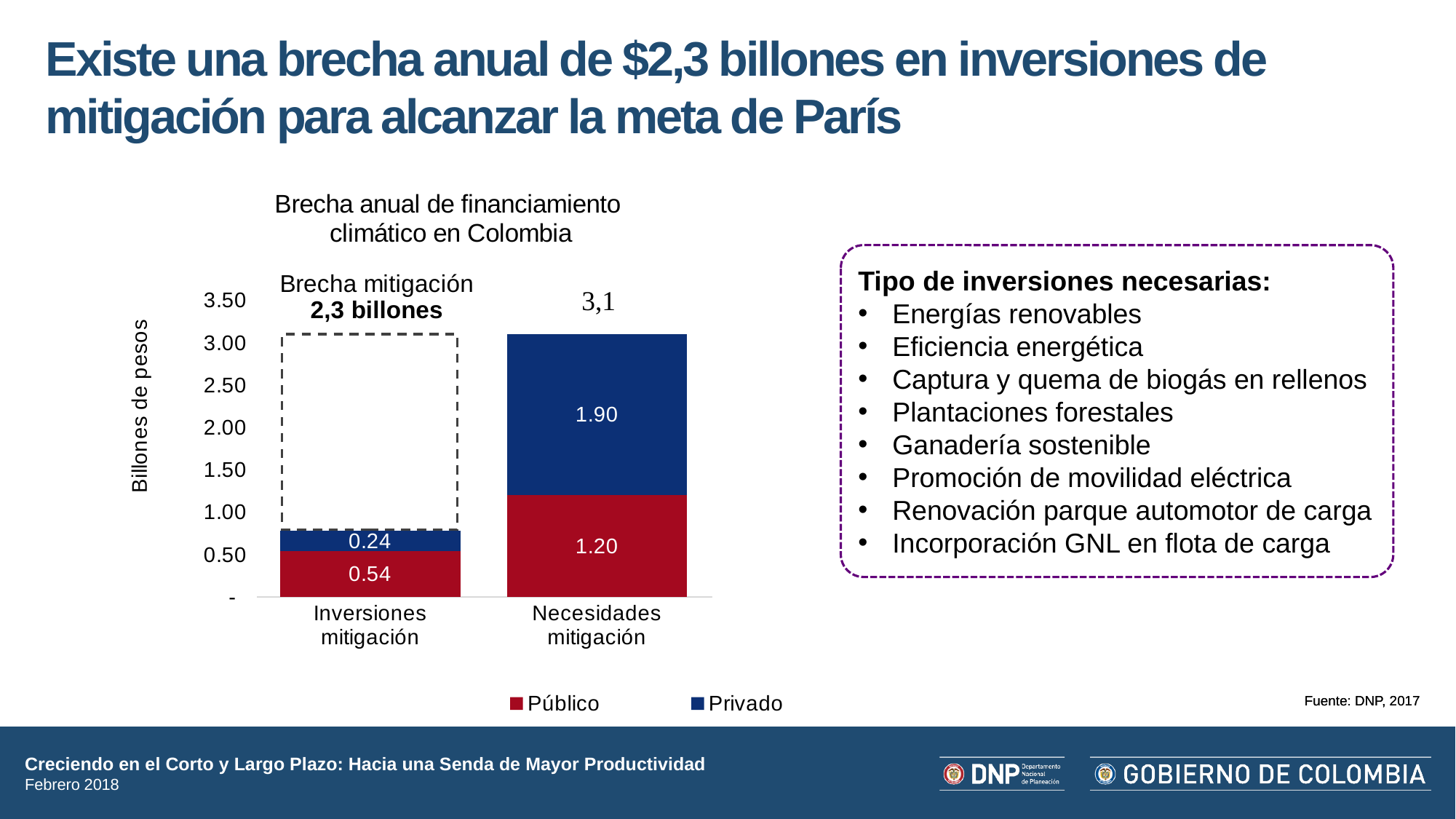
How many categories are shown on the x axis? 2 What is the title of the chart? Brecha anual de financiamiento climático en Colombia What is the total of the Necesidades mitigación stacked bar as labelled on the chart? 3,1 How many series does the legend list? 2 What is the Privado value for Inversiones mitigación? 0.24 What is the Público value for Necesidades mitigación? 1.20 What is the difference between the Privado values for Necesidades mitigación and Inversiones mitigación? 1.66 What is the Público value for Inversiones mitigación? 0.54 What kind of chart is shown on the slide? Stacked bar chart What is the Privado value for Necesidades mitigación? 1.90 What is the total of the Inversiones mitigación stacked bar (Público plus Privado)? 0.78 Which is larger for Necesidades mitigación, the Público or the Privado value? Privado